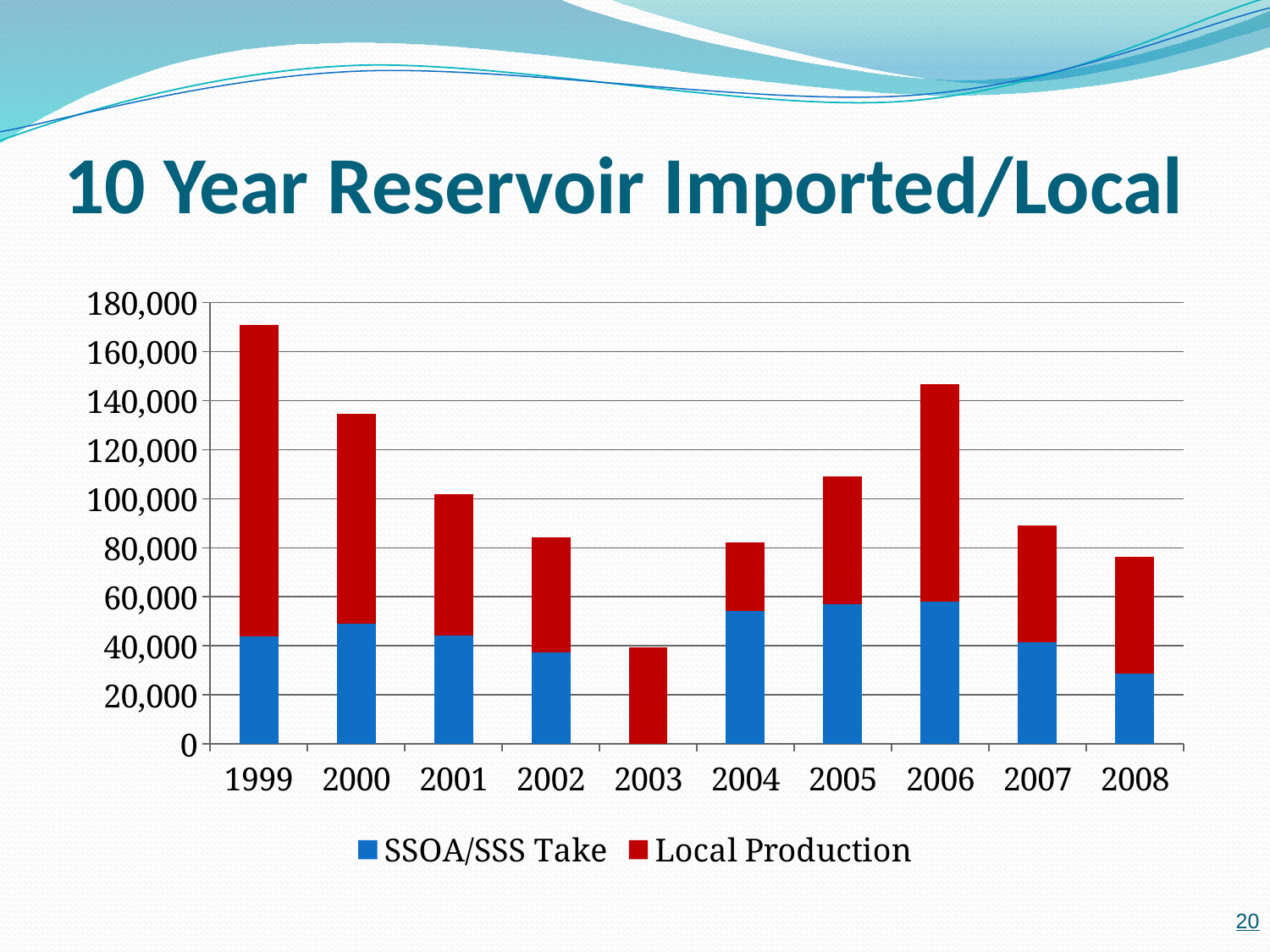
Which year has the larger total bar, 2000 or 2001? 2000 Is the SSOA/SSS Take value for 2006 greater or less than 40,000? greater How many years are shown on the x axis of the chart? 10 Which year has the lowest total bar in the chart? 2003 Is the total bar for 2006 greater or less than 140,000? greater What are the two series named in the chart's legend? SSOA/SSS Take and Local Production Is the total bar for 1999 greater or less than 160,000? greater How many series does the chart's legend list? 2 Do the total bars rise or fall from 1999 to 2003? fall Which year has the highest total bar in the chart? 1999 What kind of chart is shown on the slide? Stacked bar chart